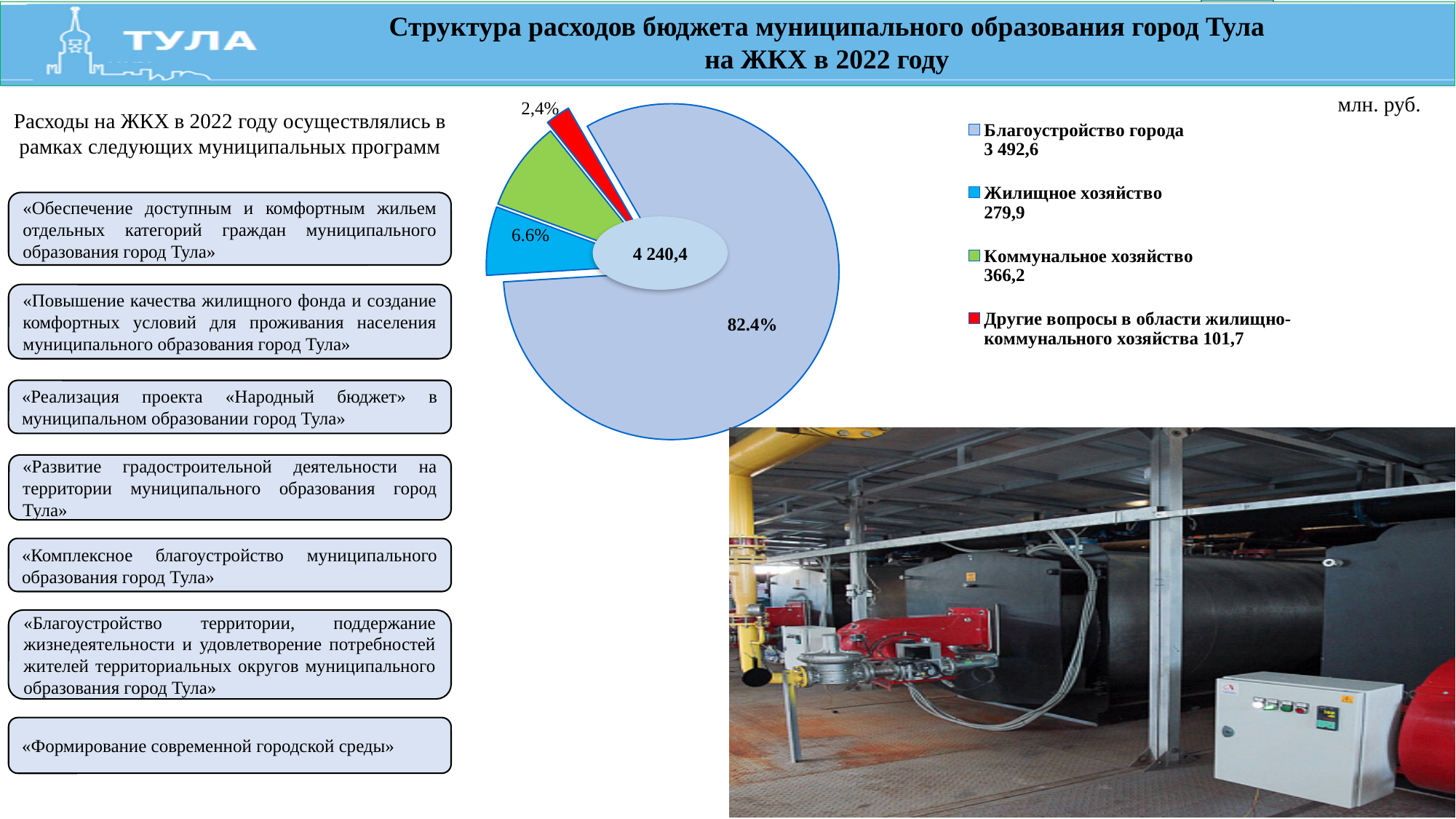
How many slices does the pie chart have? 4 What share of the pie does Благоустройство города represent, as labelled on the chart? 82.4% What share of the pie does Жилищное хозяйство represent, as labelled on the chart? 6.6% Which category has the smallest slice of the pie chart? Другие вопросы в области жилищно-коммунального хозяйства What total value is shown in the centre of the pie chart? 4 240,4 Which is larger in the pie chart: Коммунальное хозяйство or Жилищное хозяйство? Коммунальное хозяйство What is the value for Благоустройство города in the pie chart? 3 492,6 Which category has the largest slice of the pie chart? Благоустройство города What is the value for Коммунальное хозяйство in the pie chart? 366,2 What is the value for Другие вопросы в области жилищно-коммунального хозяйства in the pie chart? 101,7 What is the value for Жилищное хозяйство in the pie chart? 279,9 What kind of chart is shown on the slide? pie chart